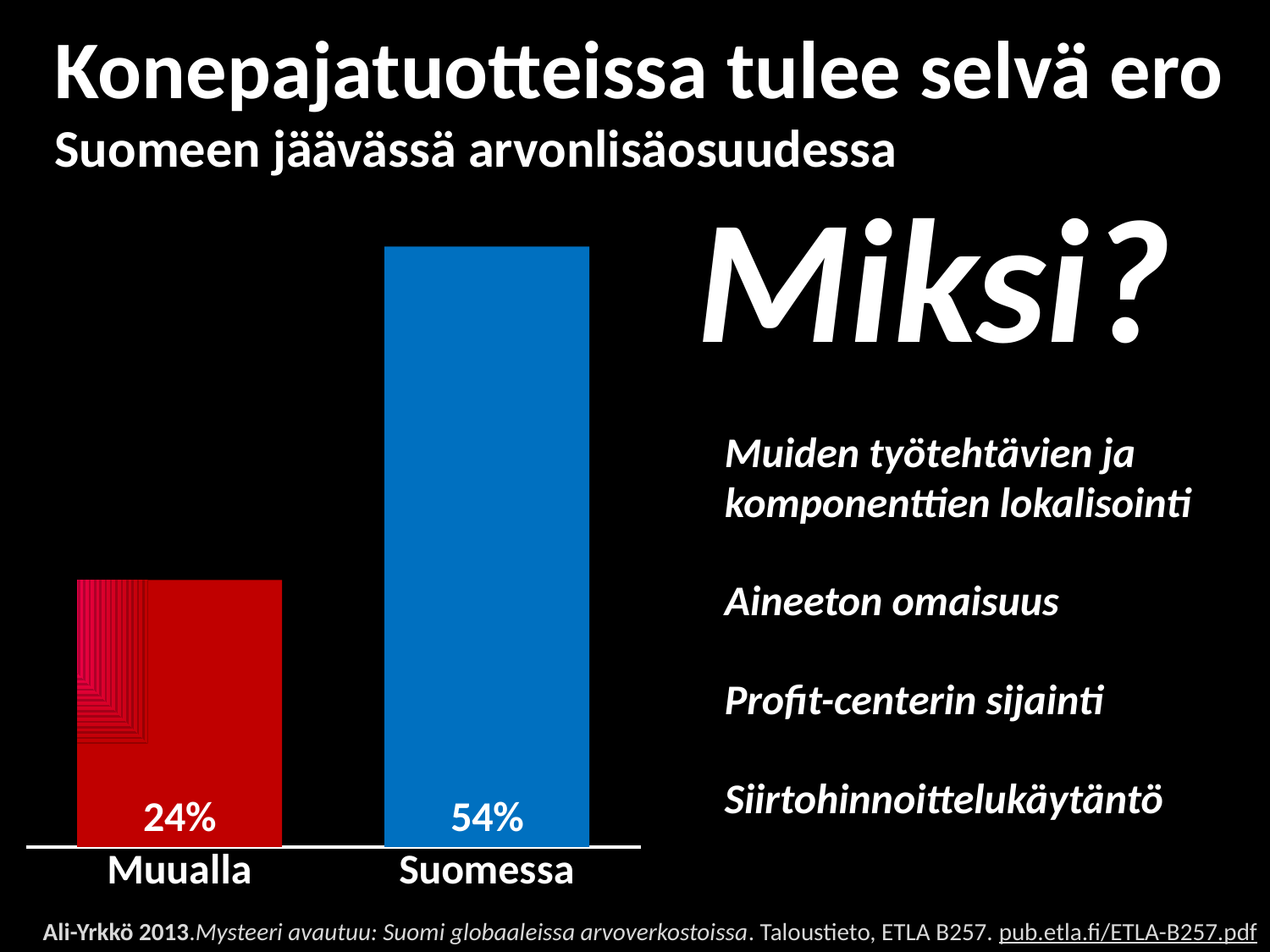
What is the difference between the values for Suomessa and Muualla? 30% How many categories are shown in the chart? 2 What colour is the bar for Muualla? red Which is larger, the value for Muualla or the value for Suomessa? Suomessa What is the value for Muualla? 24% What is the value for Suomessa? 54% What colour is the bar for Suomessa? blue What kind of chart is shown on the slide? bar chart Which category has the lowest value? Muualla Which category has the highest value? Suomessa